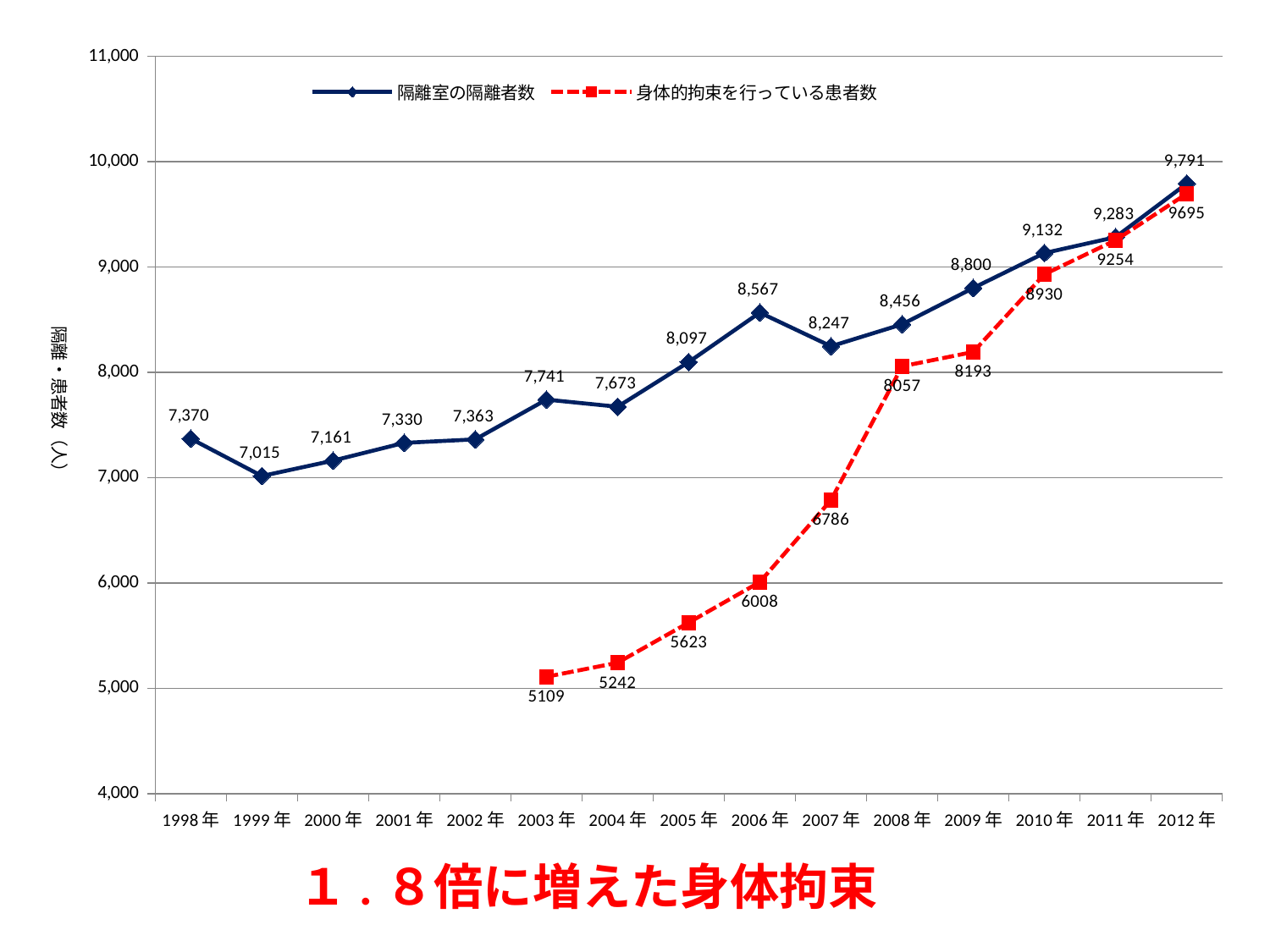
What is the difference between 隔離室の隔離者数 and 身体的拘束を行っている患者数 in 2003年? 2,632 In which year is 隔離室の隔離者数 lowest? 1999年 How many years are shown on the x axis? 15 What kind of chart is shown on the slide? Line chart What is the value of 隔離室の隔離者数 in 2006年? 8,567 How many series does the legend list? 2 What is the value of 身体的拘束を行っている患者数 in 2008年? 8057 What colour is the line for 身体的拘束を行っている患者数? Red In which year is 身体的拘束を行っている患者数 highest? 2012年 Which is larger in 2007年: 隔離室の隔離者数 or 身体的拘束を行っている患者数? 隔離室の隔離者数 Does 身体的拘束を行っている患者数 rise or fall from 2003年 to 2012年? Rise What is the value of 隔離室の隔離者数 in 1998年? 7,370